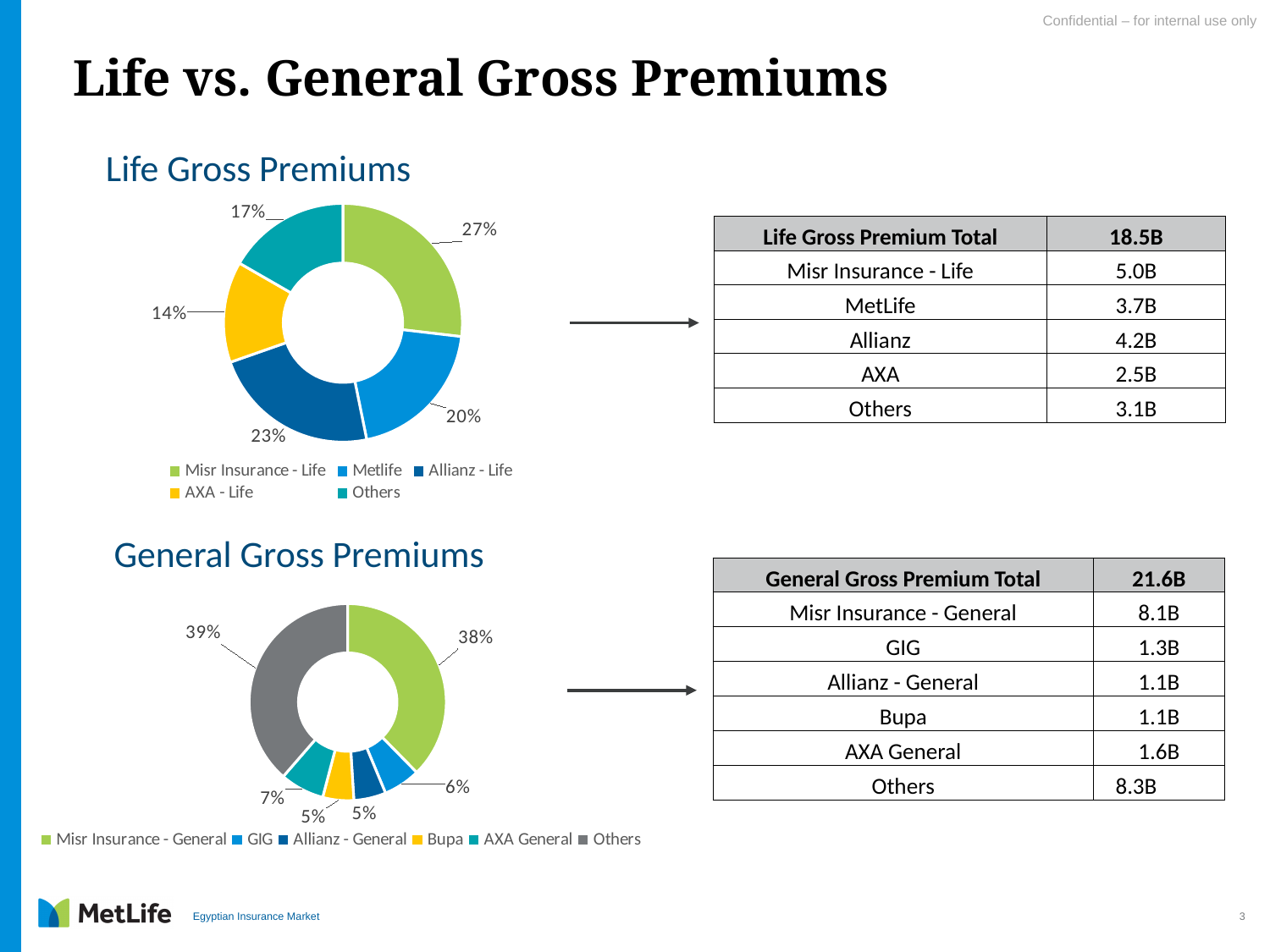
In the Life Gross Premiums chart, what share does Misr Insurance - Life hold? 27% In the Life Gross Premiums chart, which category has the largest share? Misr Insurance - Life How many entries does the legend of the General Gross Premiums chart list? 6 In the General Gross Premiums chart, what share does AXA General hold? 7% In the Life Gross Premiums chart, which category has the smallest share? AXA - Life What type of chart is the General Gross Premiums chart? Doughnut chart In the Life Gross Premiums chart, what is the difference in percentage points between Allianz - Life and Metlife? 3 In the General Gross Premiums chart, which is larger, AXA General or Bupa? AXA General How many categories does the Life Gross Premiums chart show? 5 In the General Gross Premiums chart, what percentage is shown for GIG? 6% In the Life Gross Premiums chart, which is larger, Others or AXA - Life? Others In the Life Gross Premiums chart, what percentage is shown for AXA - Life? 14%